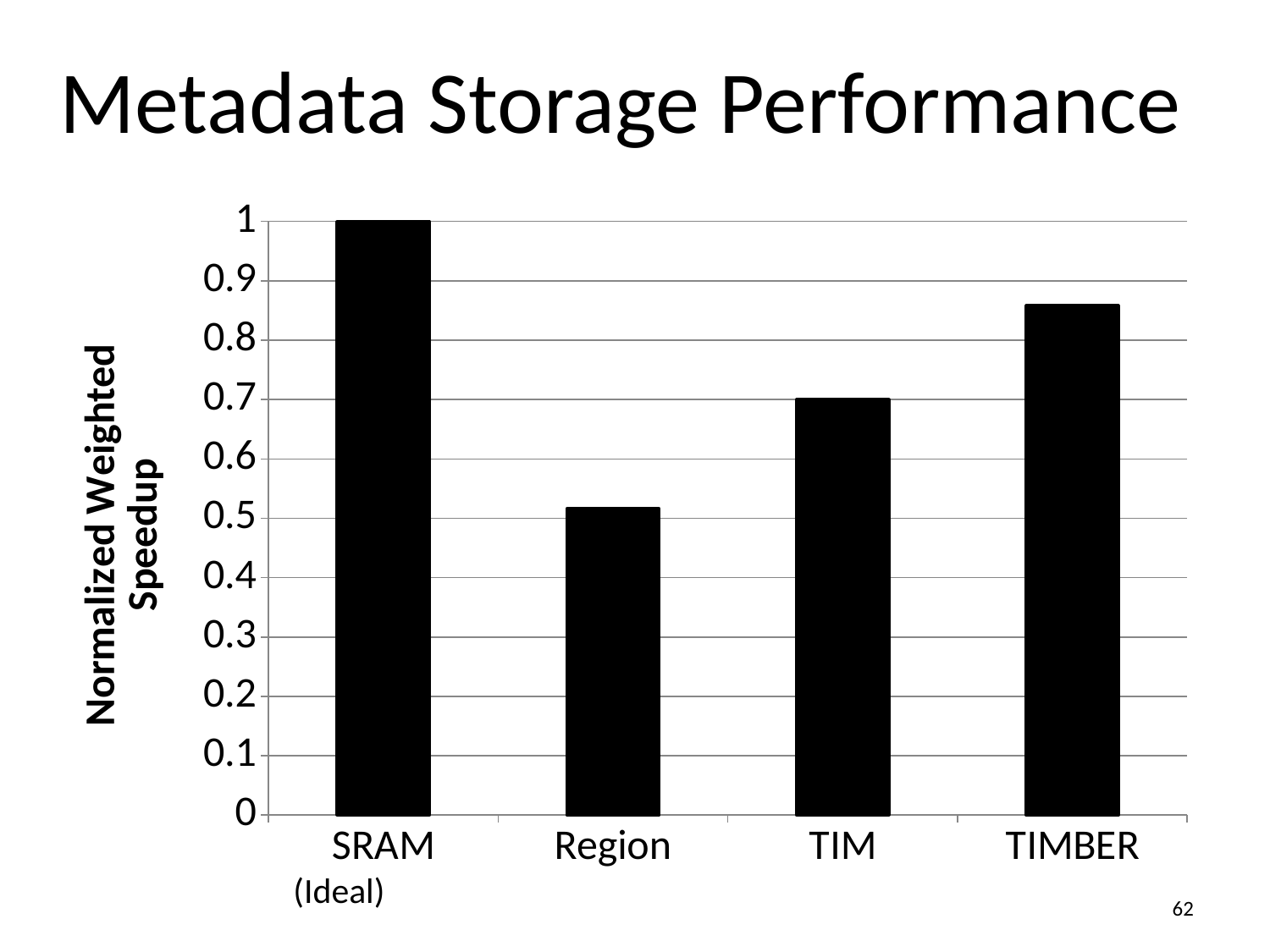
Is the value for TIM greater or less than 0.6? greater Which category has the lowest Normalized Weighted Speedup? Region Is the value for Region greater or less than 0.6? less What kind of chart is shown on the slide? bar chart Is the value for TIMBER greater or less than 0.8? greater What is the label on the vertical axis of the chart? Normalized Weighted Speedup Which has a larger Normalized Weighted Speedup, Region or TIM? TIM Which has a larger Normalized Weighted Speedup, TIM or TIMBER? TIMBER How many categories are plotted on the x axis? 4 What is the Normalized Weighted Speedup for SRAM (Ideal)? 1 Which category has the highest Normalized Weighted Speedup? SRAM (Ideal)